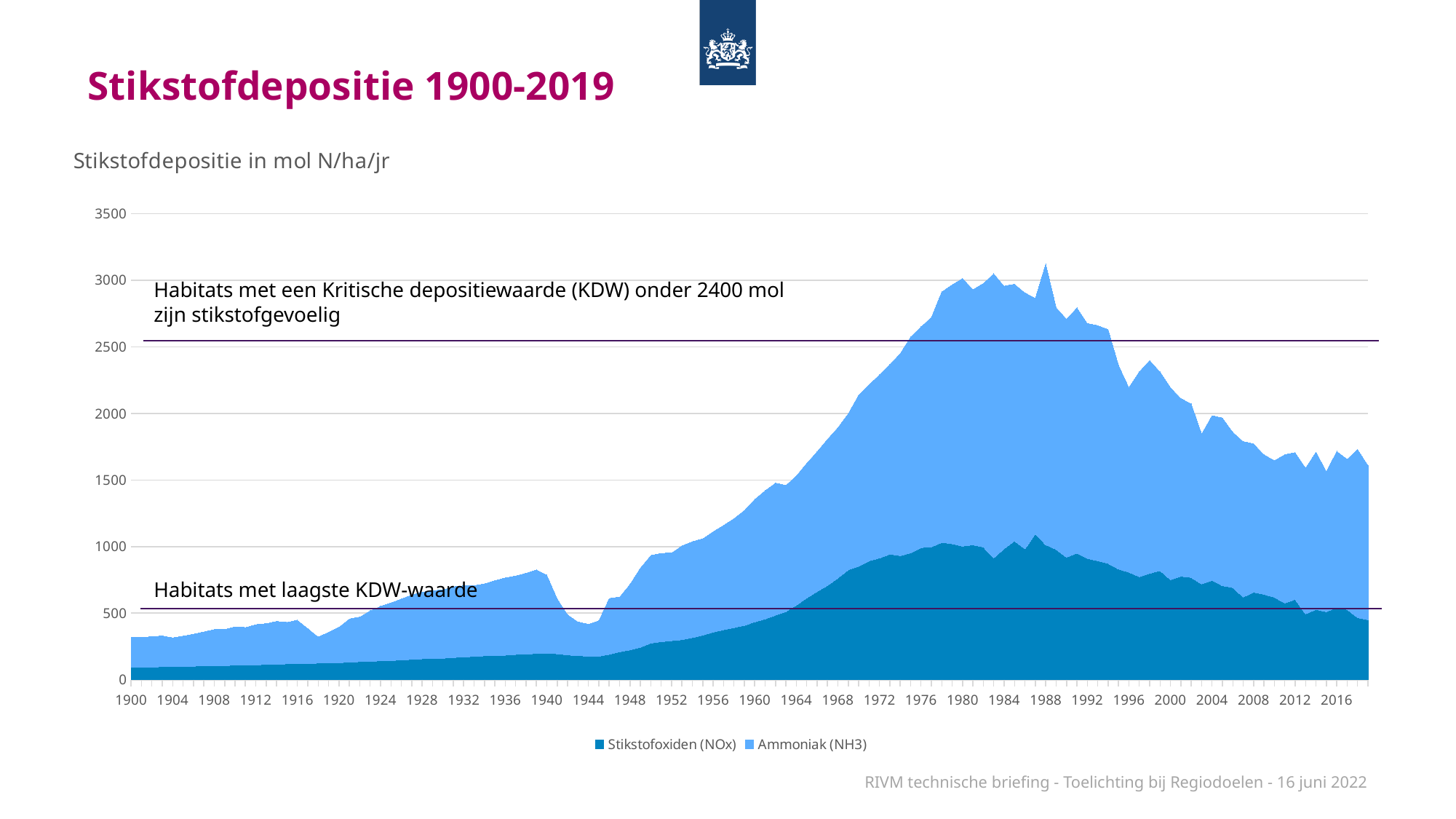
Is the Stikstofoxiden (NOx) value in 1960 greater or less than 500? less Which two series are listed in the legend? Stikstofoxiden (NOx) and Ammoniak (NH3) Is the Stikstofoxiden (NOx) value in 1980 greater or less than 500? greater Does the total stikstofdepositie rise or fall between 1988 and 2016? fall Is the total stikstofdepositie in 1960 greater or less than 1500? less What kind of chart is shown on the slide? Stacked area chart Does the total stikstofdepositie rise or fall between 1948 and 1980? rise How many series does the legend list? 2 What is the title of the chart? Stikstofdepositie in mol N/ha/jr